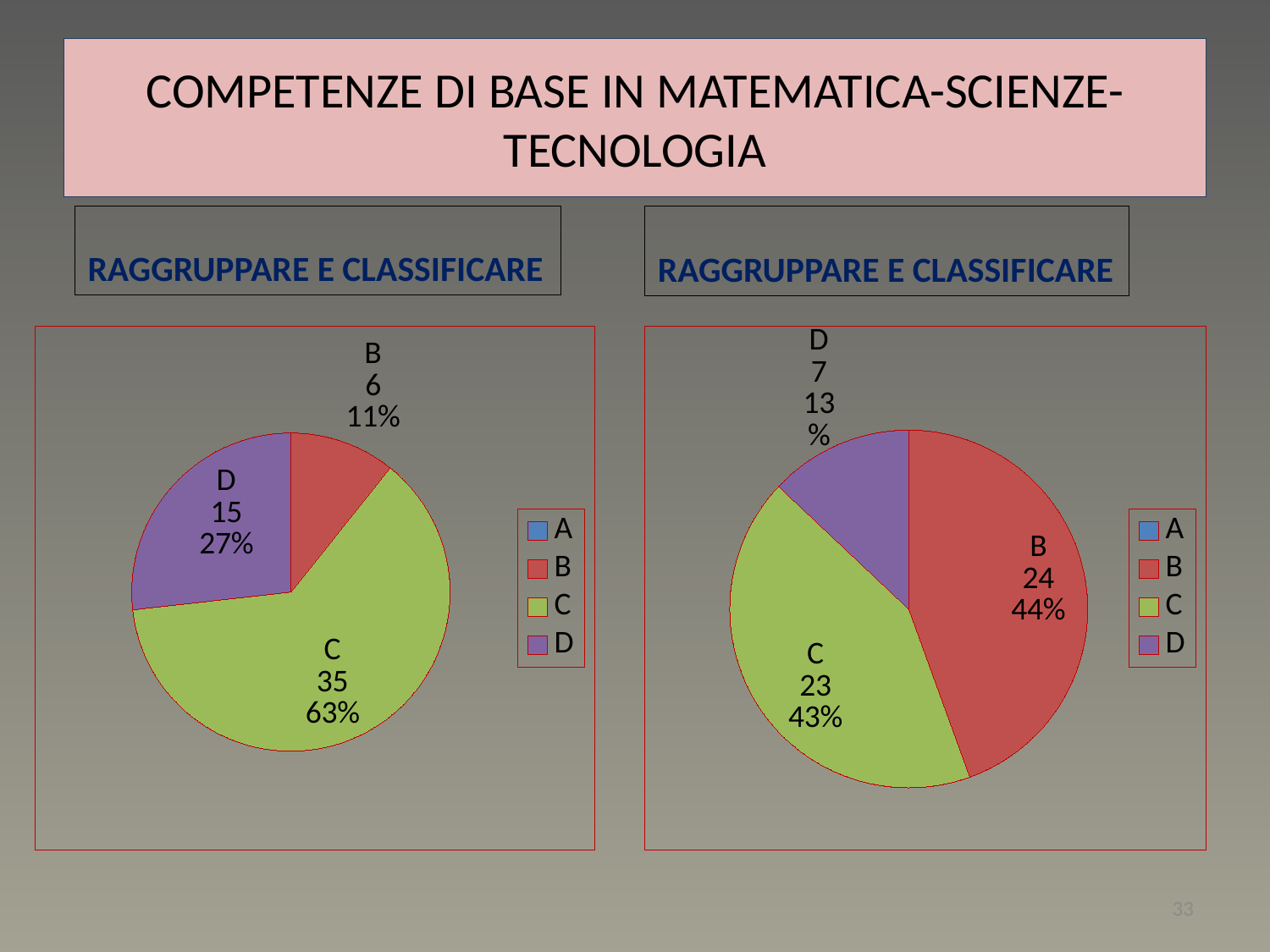
Which is larger: the value for C in the left pie chart or the value for C in the right pie chart? C in the left pie chart In the right pie chart, what is the value for category B? 24 What colour is category C in the legend of the right pie chart? Green In the left pie chart, what is the difference between the values for C and D? 20 In the right pie chart, what share of the pie does category D represent? 13% In the left pie chart, what share of the pie does category D represent? 27% In the left pie chart, which category has the smallest slice? B How many entries does the legend of the left pie chart list? 4 In the left pie chart, what is the value for category C? 35 What type of chart is shown on the right side of the slide? Pie chart In the right pie chart, which category has the largest slice? B In the right pie chart, what is the difference between the values for B and D? 17